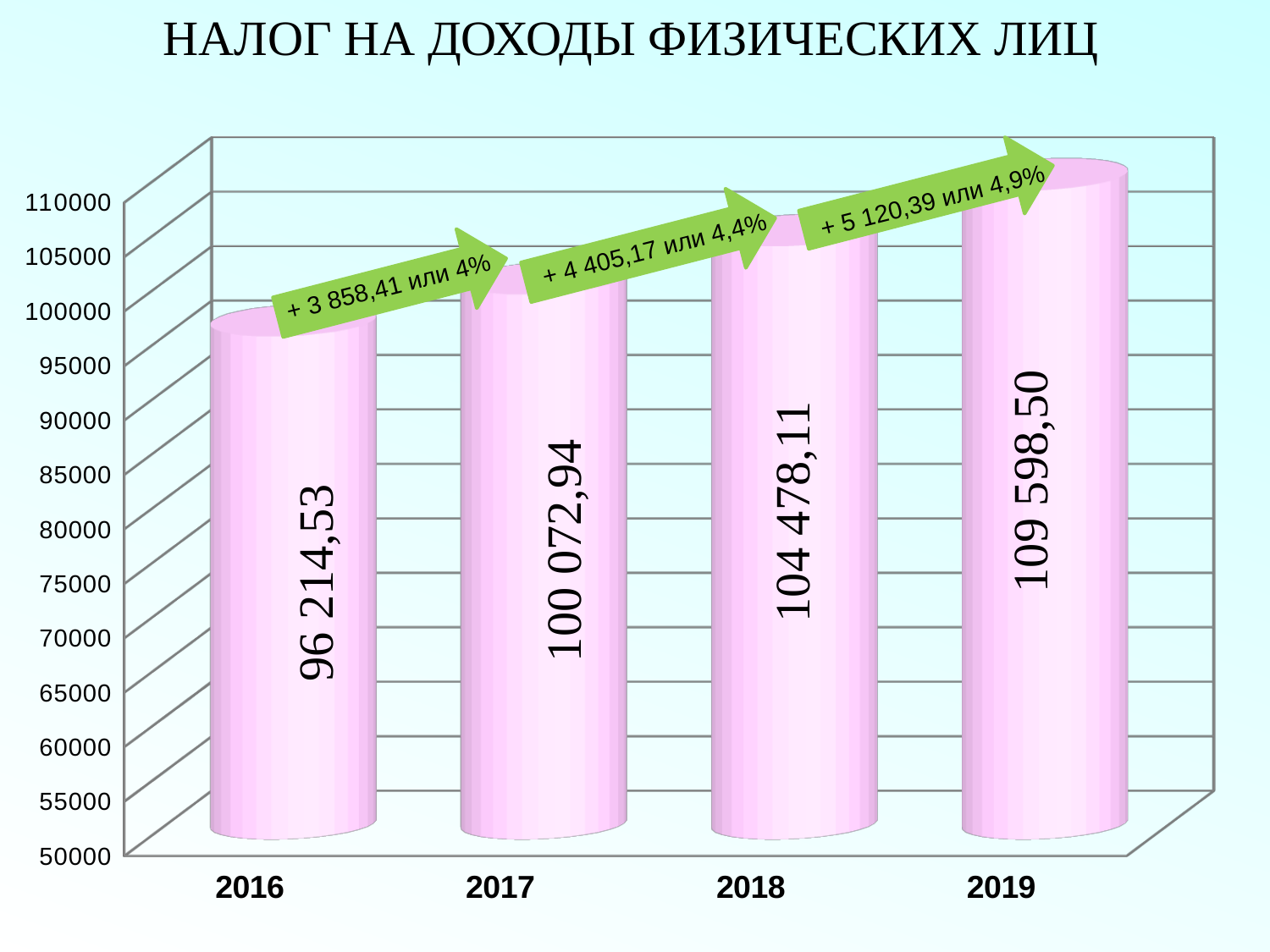
What is the value for 2018? 104 478,11 Which is larger, the value for 2018 or the value for 2017? 2018 Do the values rise or fall from 2016 to 2019? Rise Which year has the highest value? 2019 Which year has the lowest value? 2016 What is the value for 2019? 109 598,50 What is the value for 2017? 100 072,94 What is the value for 2016? 96 214,53 What is the difference between the values for 2017 and 2016? 3 858,41 What kind of chart is shown on the slide? Bar chart What is the difference between the values for 2019 and 2018? 5 120,39 How many years are shown on the x axis? 4